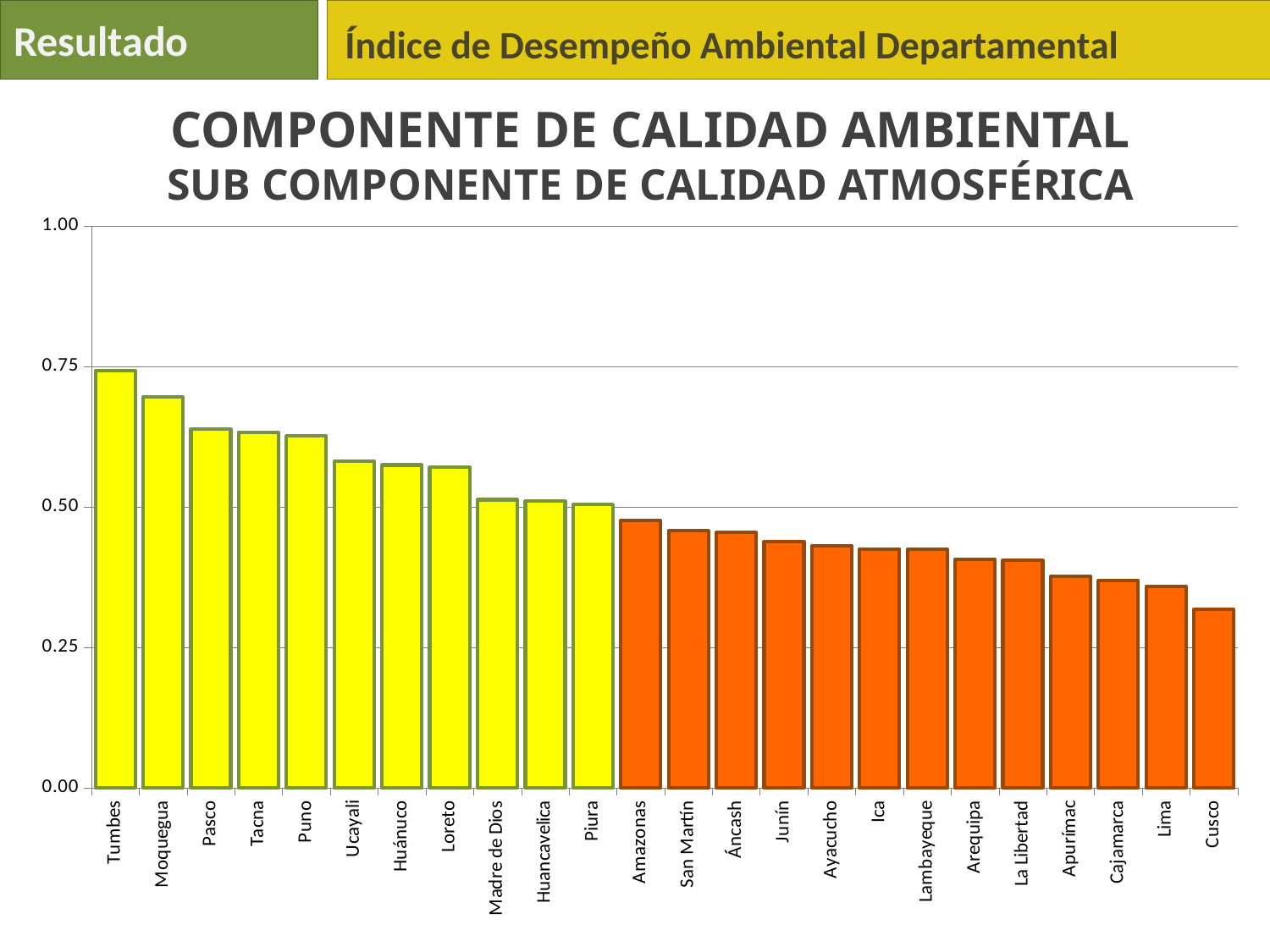
Which has the larger value, Cusco or Pasco? Pasco Is the value for Amazonas greater or less than 0.50? less What kind of chart is shown on the slide? bar chart What is the subtitle of the chart shown below the main title 'COMPONENTE DE CALIDAD AMBIENTAL'? SUB COMPONENTE DE CALIDAD ATMOSFÉRICA Do the values rise or fall moving from left to right along the x axis? fall Is the value for Cusco greater or less than 0.25? greater Which department has the highest value in the chart? Tumbes Which has the larger value, Moquegua or Lima? Moquegua Is the value for Moquegua greater or less than 0.50? greater Which department has the lowest value in the chart? Cusco How many departments are shown on the x axis of the chart? 24